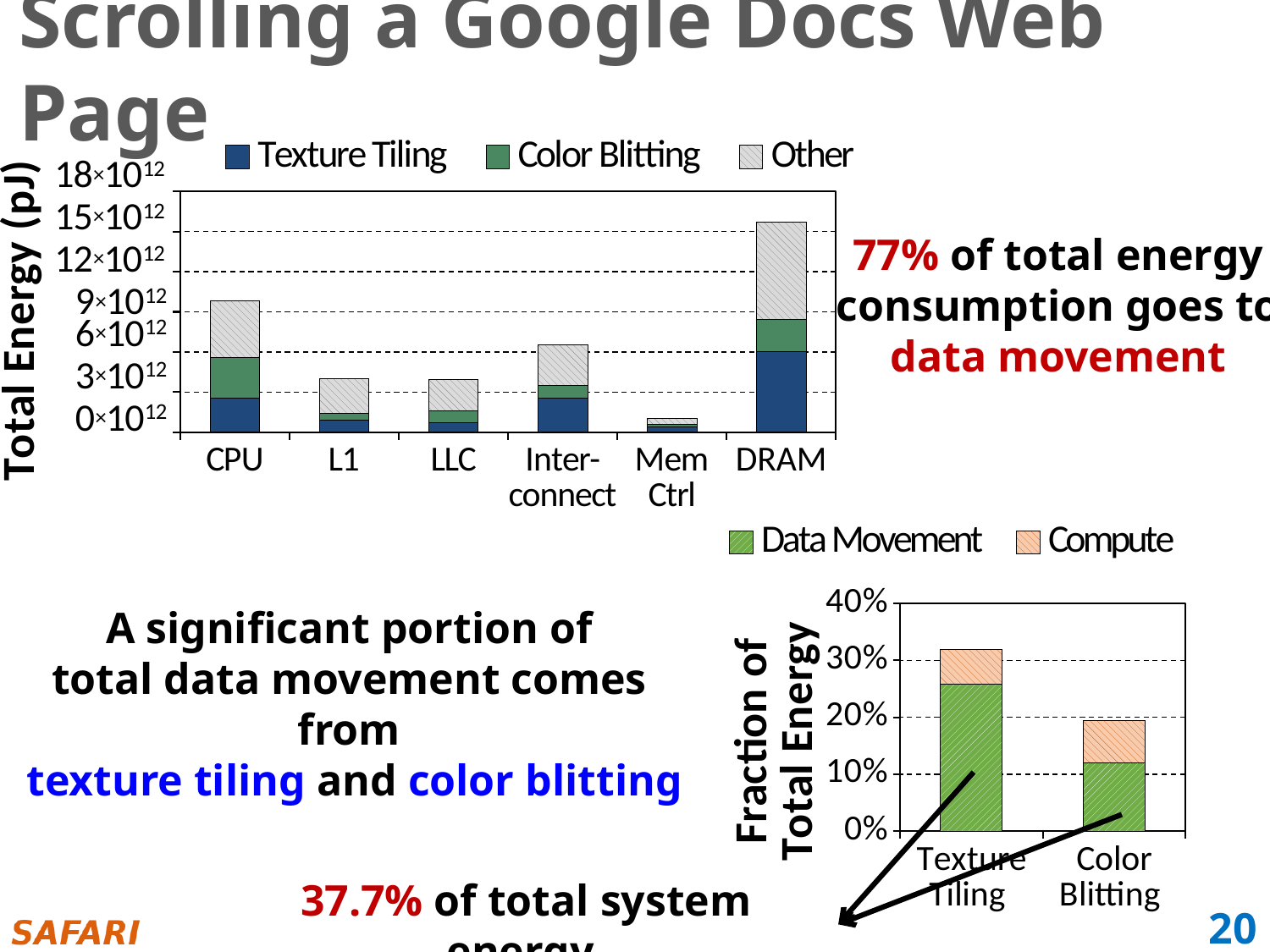
In the top chart (Total Energy), which category has the highest total energy? DRAM In the top chart (Total Energy), which has a larger total energy, CPU or LLC? CPU In the top chart (Total Energy), is the total value for L1 greater or less than 6×10^12? less In the bottom chart (Fraction of Total Energy), is the total value for Texture Tiling greater or less than 30%? greater In the top chart (Total Energy), is the total value for DRAM greater or less than 12×10^12? greater In the top chart (Total Energy), how many series does the legend list? 3 What kind of chart is the top chart showing Total Energy (pJ)? stacked bar chart In the top chart (Total Energy), what are the three legend entries? Texture Tiling, Color Blitting, Other In the bottom chart (Fraction of Total Energy), which category has the larger total bar, Texture Tiling or Color Blitting? Texture Tiling In the bottom chart (Fraction of Total Energy), how many series does the legend list? 2 In the top chart (Total Energy), which category has the lowest total energy? Mem Ctrl In the top chart (Total Energy), how many categories are shown on the x axis? 6